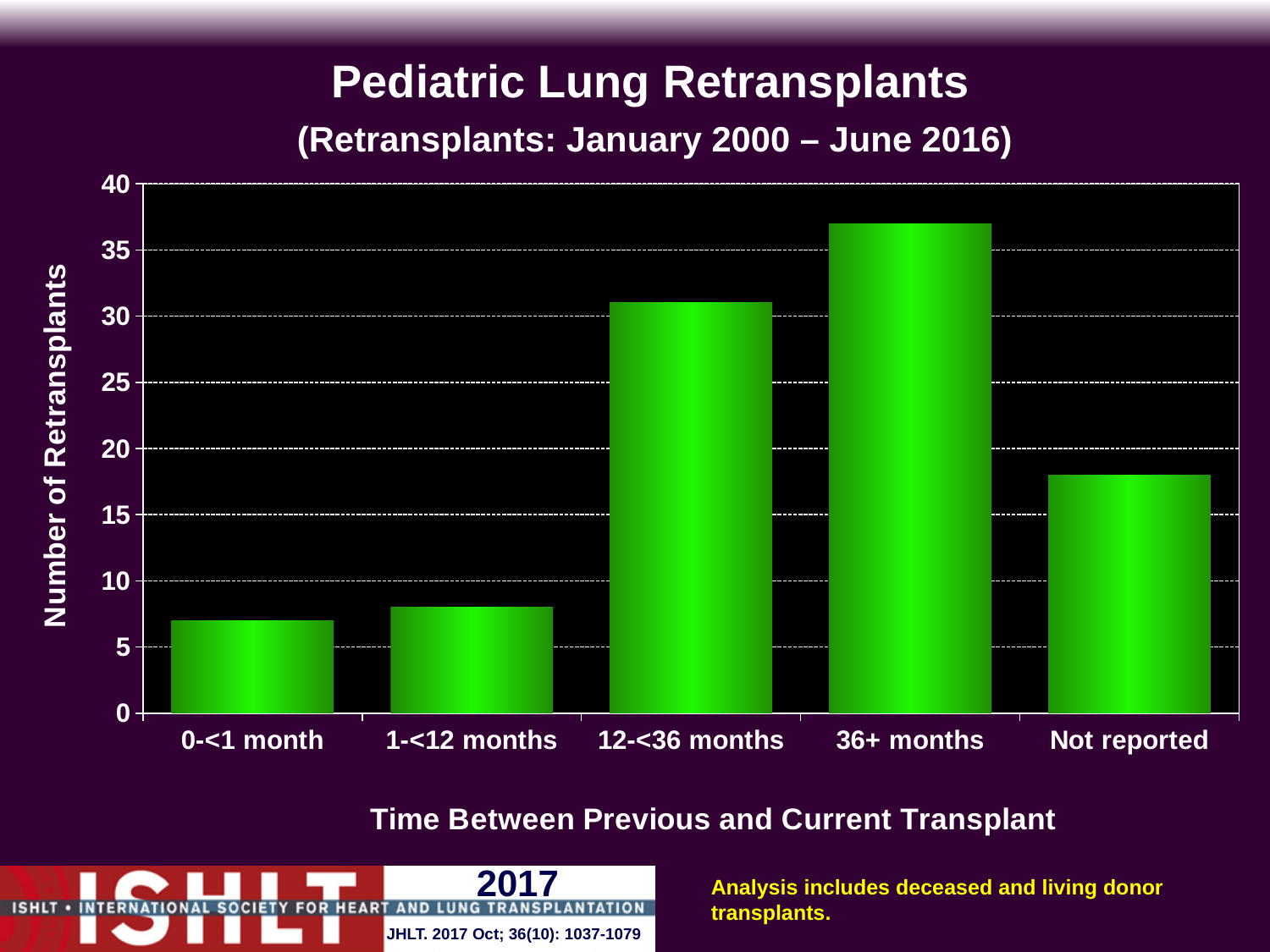
How many categories are shown on the x axis of the chart? 5 Is the number of retransplants for 36+ months greater or less than 35? greater Which has more retransplants, 1-<12 months or Not reported? Not reported Is the number of retransplants for 12-<36 months greater or less than 30? greater What type of chart is shown on the slide? bar chart Which time-between-transplants category has the highest number of retransplants? 36+ months Is the number of retransplants for Not reported greater or less than 20? less Which has more retransplants, 12-<36 months or 36+ months? 36+ months What is the label of the y axis of the chart? Number of Retransplants